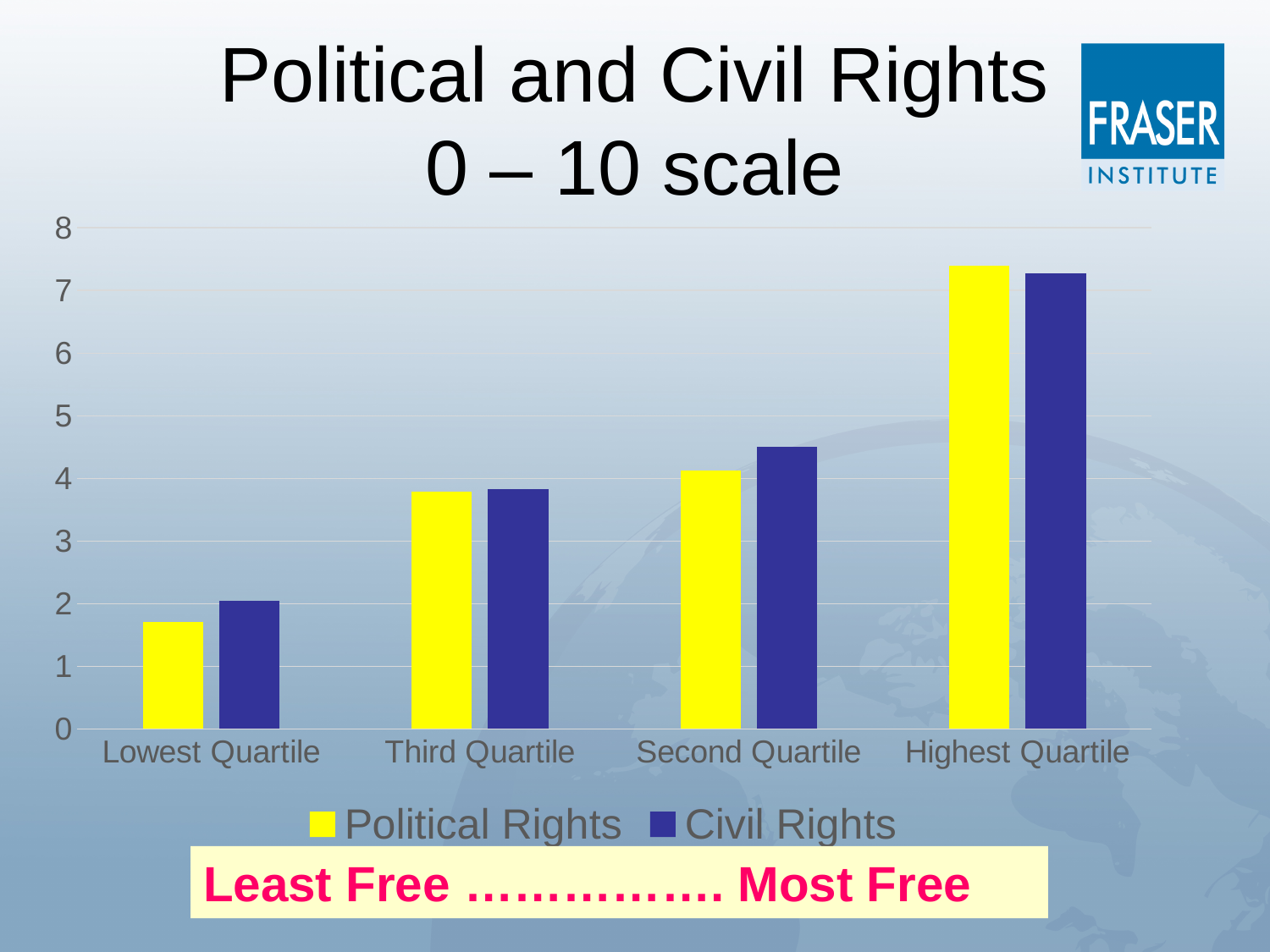
Do the Political Rights values rise or fall from Lowest Quartile to Highest Quartile? Rise How many categories are shown on the x axis? 4 Is the Political Rights value for the Lowest Quartile greater or less than 2? less Which category has the highest Political Rights value? Highest Quartile How many series does the legend list? 2 Which category has the lowest Civil Rights value? Lowest Quartile In the Second Quartile, which is larger: Political Rights or Civil Rights? Civil Rights What kind of chart is shown on the slide? Bar chart Is the Political Rights value for the Highest Quartile greater or less than 7? greater Which colour represents Civil Rights in the legend? Blue Is the Civil Rights value for the Second Quartile greater or less than 4? greater In the Lowest Quartile, which is larger: Political Rights or Civil Rights? Civil Rights